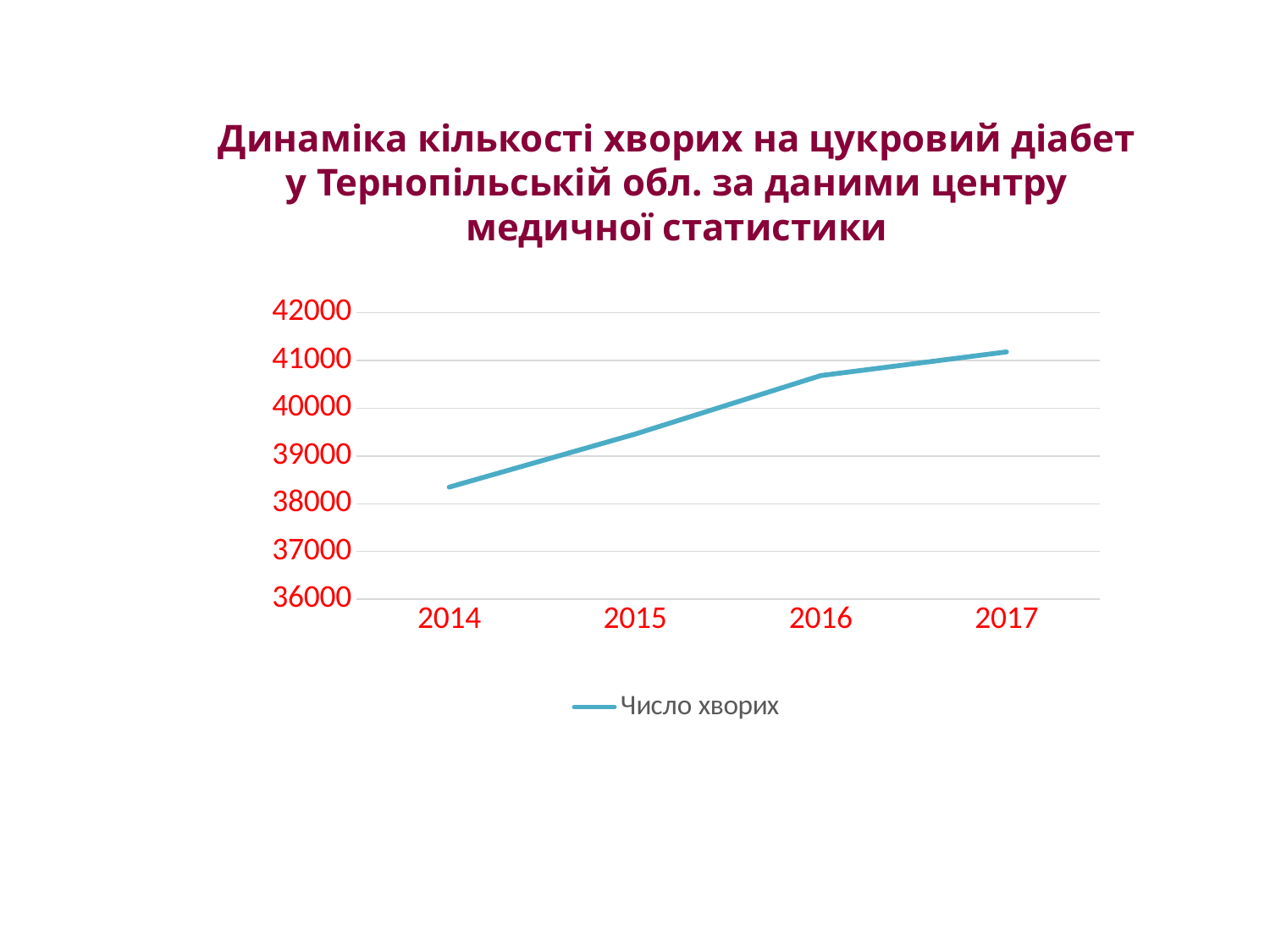
Which year has the lowest number of patients? 2014 How many years are plotted on the x axis? 4 Do the values rise or fall from 2014 to 2017? rise Is the value for 2014 greater or less than 39000? less Which year has the highest number of patients? 2017 Is the value for 2015 greater or less than 39000? greater What is the name of the series shown in the legend? Число хворих Which year has the larger value, 2015 or 2016? 2016 How many series does the legend list? 1 Is the value for 2014 greater or less than 38000? greater What kind of chart is shown on the slide? line chart